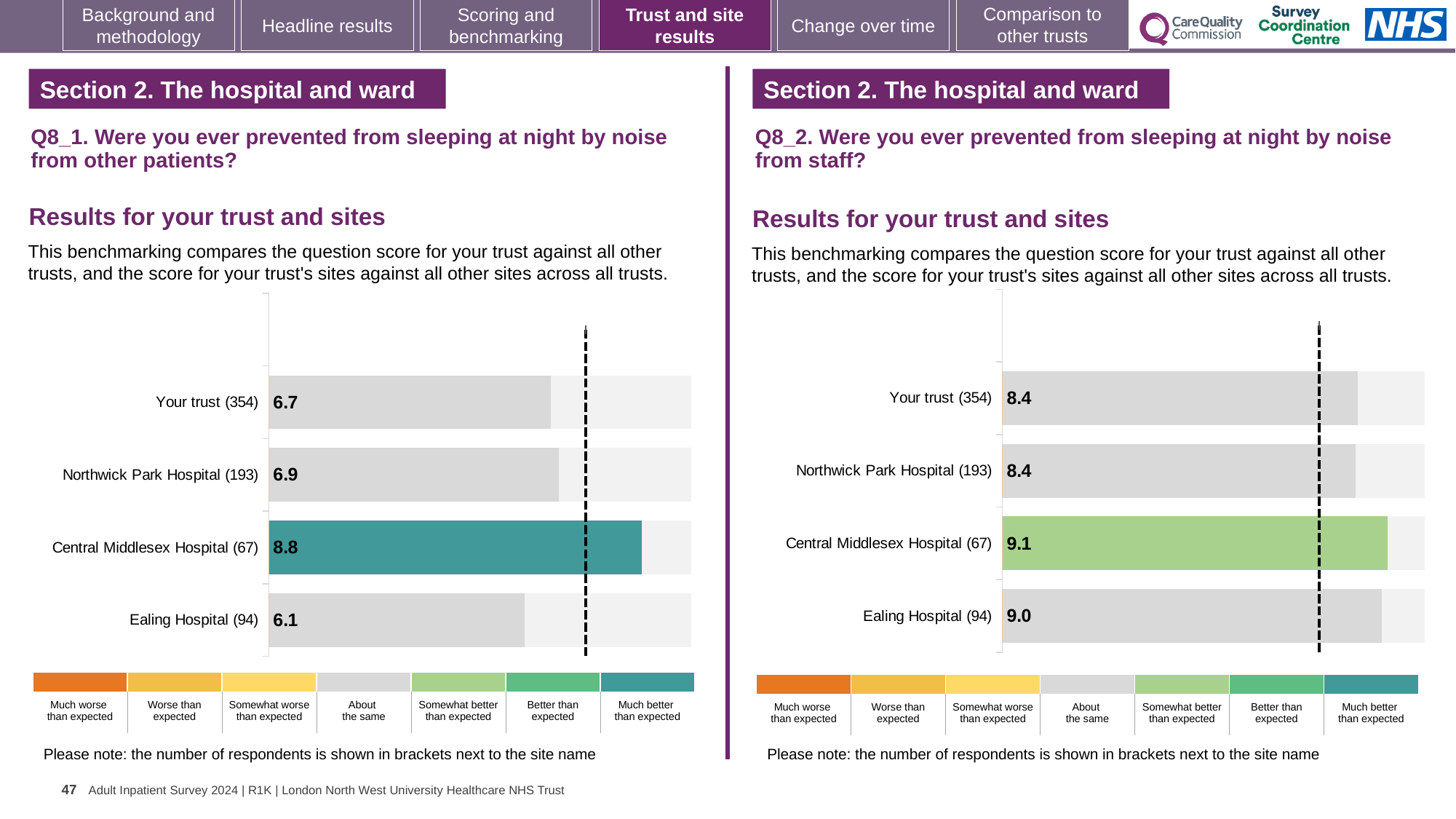
On the Q8_1 chart (left), which has the larger score, Your trust (354) or Ealing Hospital (94)? Your trust (354) On the Q8_1 chart (left), which site has the highest score? Central Middlesex Hospital (67) How many bars are shown on the Q8_2 chart (right)? 4 On the Q8_1 chart (left), what is the score for Ealing Hospital (94)? 6.1 On the Q8_1 chart (left), what is the difference between the scores for Central Middlesex Hospital (67) and Northwick Park Hospital (193)? 1.9 On the Q8_2 chart (right), what is the score for Central Middlesex Hospital (67)? 9.1 On the Q8_1 chart (left), which site has the lowest score? Ealing Hospital (94) On the Q8_2 chart (right), what is the difference between the scores for Ealing Hospital (94) and Your trust (354)? 0.6 What type of chart is used on the Q8_1 chart (left)? Bar chart On the Q8_1 chart (left), what is the score for Your trust (354)? 6.7 On the Q8_2 chart (right), which site has the highest score? Central Middlesex Hospital (67) On the Q8_2 chart (right), what is the score for Northwick Park Hospital (193)? 8.4